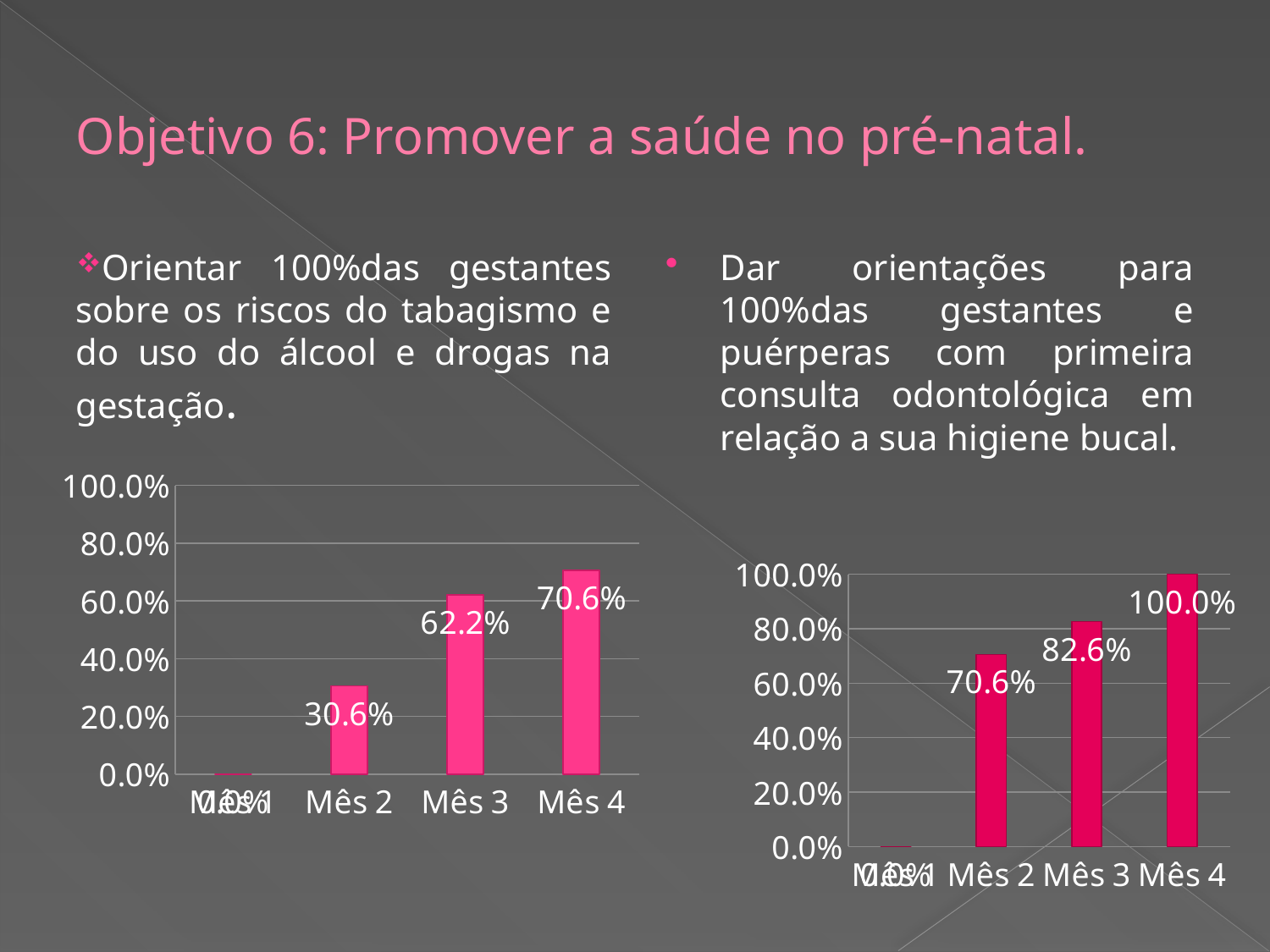
On the right chart, what is the difference between the values for Mês 4 and Mês 2? 29.4% On the left chart, what is the difference between the values for Mês 4 and Mês 3? 8.4% On the left chart, what is the value for Mês 3? 62.2% Which is larger: the value for Mês 2 on the left chart or the value for Mês 2 on the right chart? Mês 2 on the right chart On the right chart, what is the value for Mês 3? 82.6% On the right chart, which month has the lowest value? Mês 1 How many months are shown on the left chart? 4 On the right chart, what is the value for Mês 4? 100.0% On the right chart, do the values rise or fall from Mês 1 to Mês 4? Rise On the left chart, which month has the highest value? Mês 4 On the left chart, what is the value for Mês 2? 30.6% What kind of chart is the right chart? Bar chart